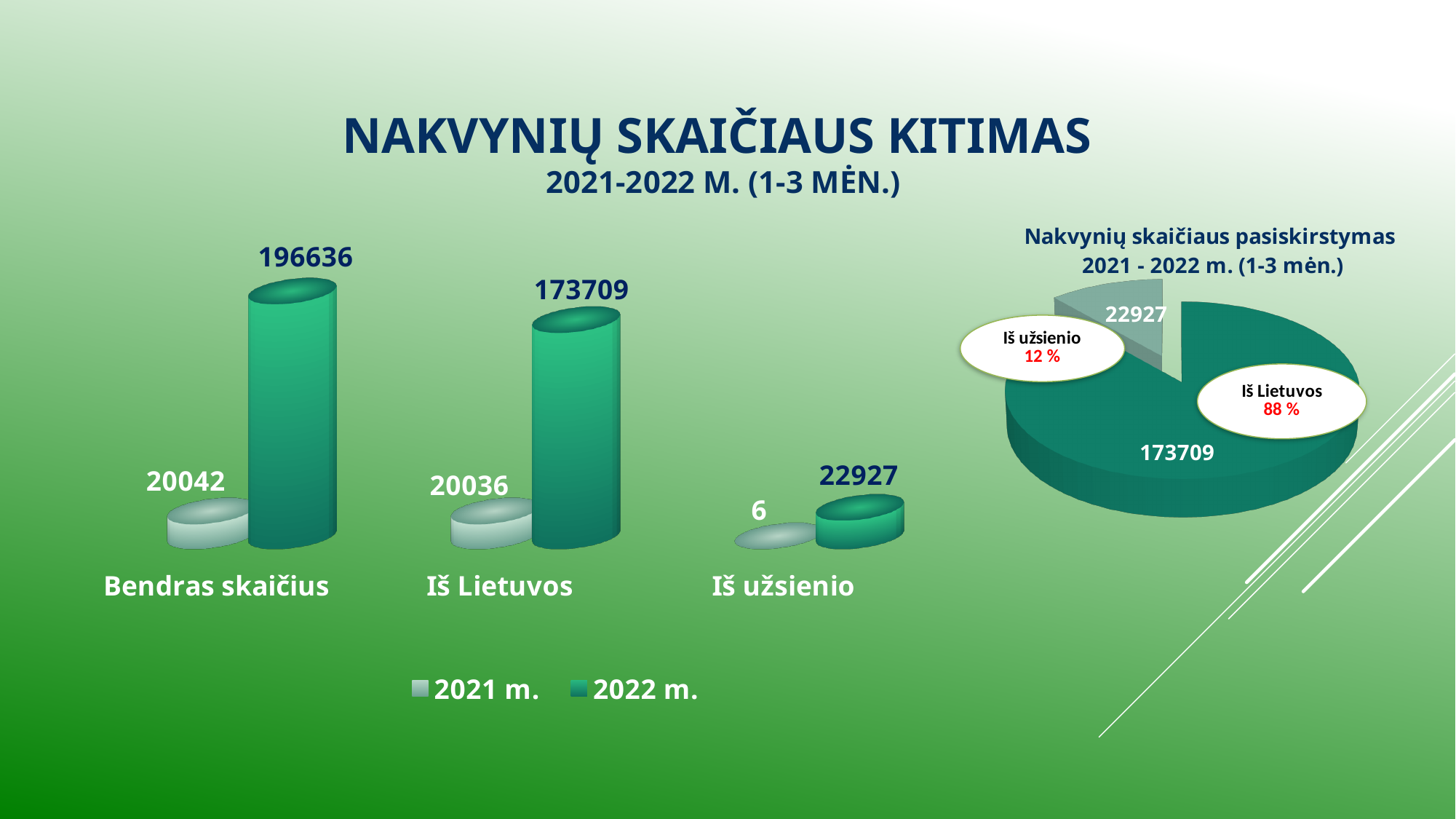
In the pie chart titled 'Nakvynių skaičiaus pasiskirstymas 2021 - 2022 m. (1-3 mėn.)', what share does Iš užsienio have? 12 % How many series does the legend of the bar chart on the left list? 2 In the bar chart on the left, what is the value for Bendras skaičius in 2022 m.? 196636 In the bar chart on the left, which category has the highest value for 2022 m.? Bendras skaičius In the bar chart on the left, what is the difference between the 2022 m. and 2021 m. values for Bendras skaičius? 176594 In the bar chart on the left, what is the value for Iš užsienio in 2021 m.? 6 How many categories are shown in the bar chart on the left? 3 In the bar chart on the left, which category has the lowest value for 2021 m.? Iš užsienio In the bar chart on the left, what is the value for Iš užsienio in 2022 m.? 22927 In the bar chart on the left, what is the value for Iš Lietuvos in 2021 m.? 20036 In the bar chart on the left, which is larger for Iš Lietuvos: the 2021 m. value or the 2022 m. value? 2022 m. What kind of chart is the chart on the right of the slide? Pie chart